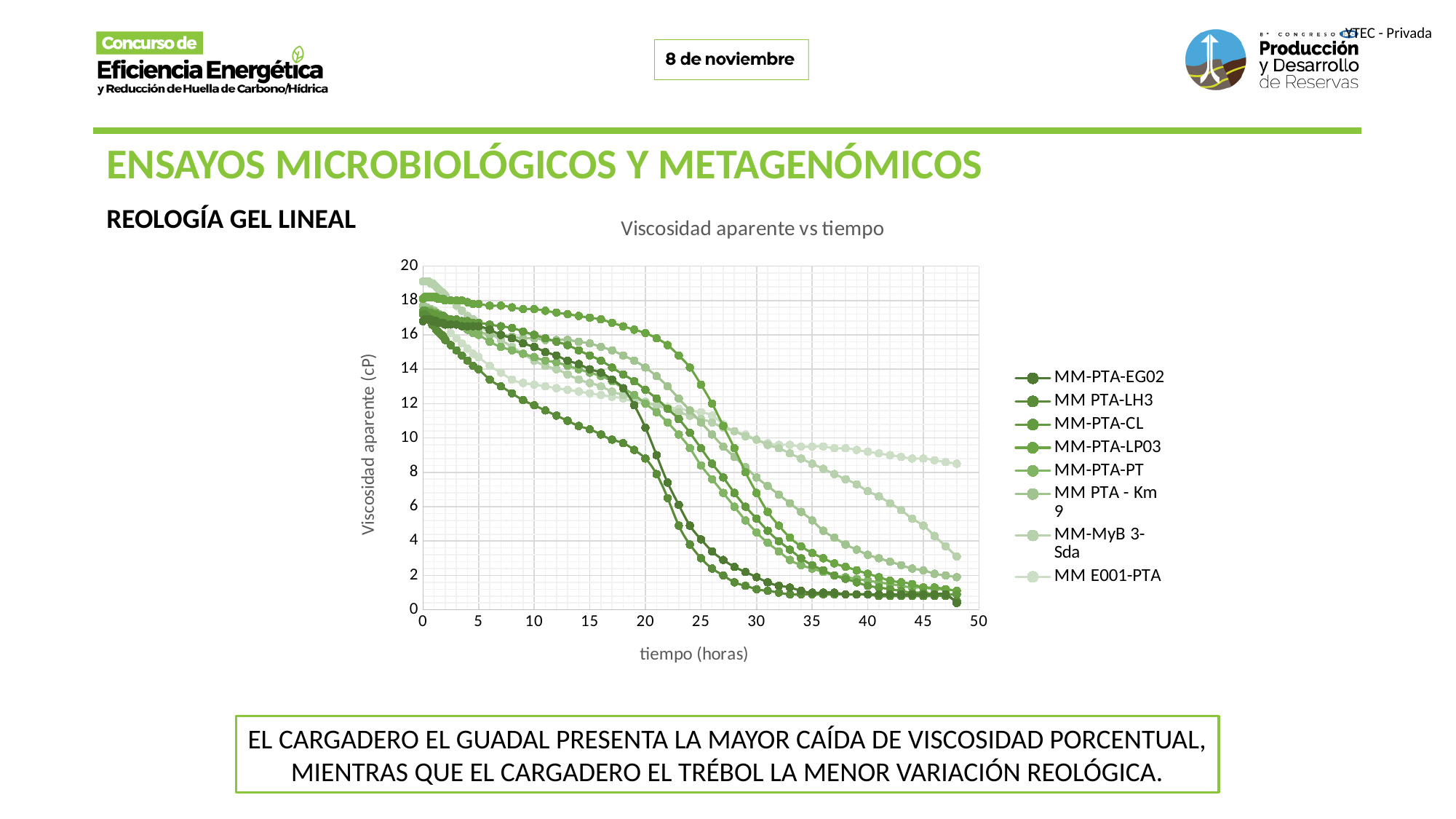
At time 0, are all series' viscosity values greater or less than 14? greater What kind of chart is shown on the slide? line chart What is the maximum value shown on the horizontal axis (tiempo) of the chart? 50 What is the label of the vertical axis of the chart? Viscosidad aparente (cP) Is the value for MM E001-PTA at 48 hours greater or less than 6? greater Do the viscosity values rise or fall as time increases along the x axis? fall How many series does the chart legend list? 8 At 48 hours, is the highest viscosity value among all series greater or less than 10? less Which series has the highest viscosity at the end of the test (around 48 hours)? MM E001-PTA What is the title of the chart? Viscosidad aparente vs tiempo What is the maximum value shown on the vertical axis of the chart? 20